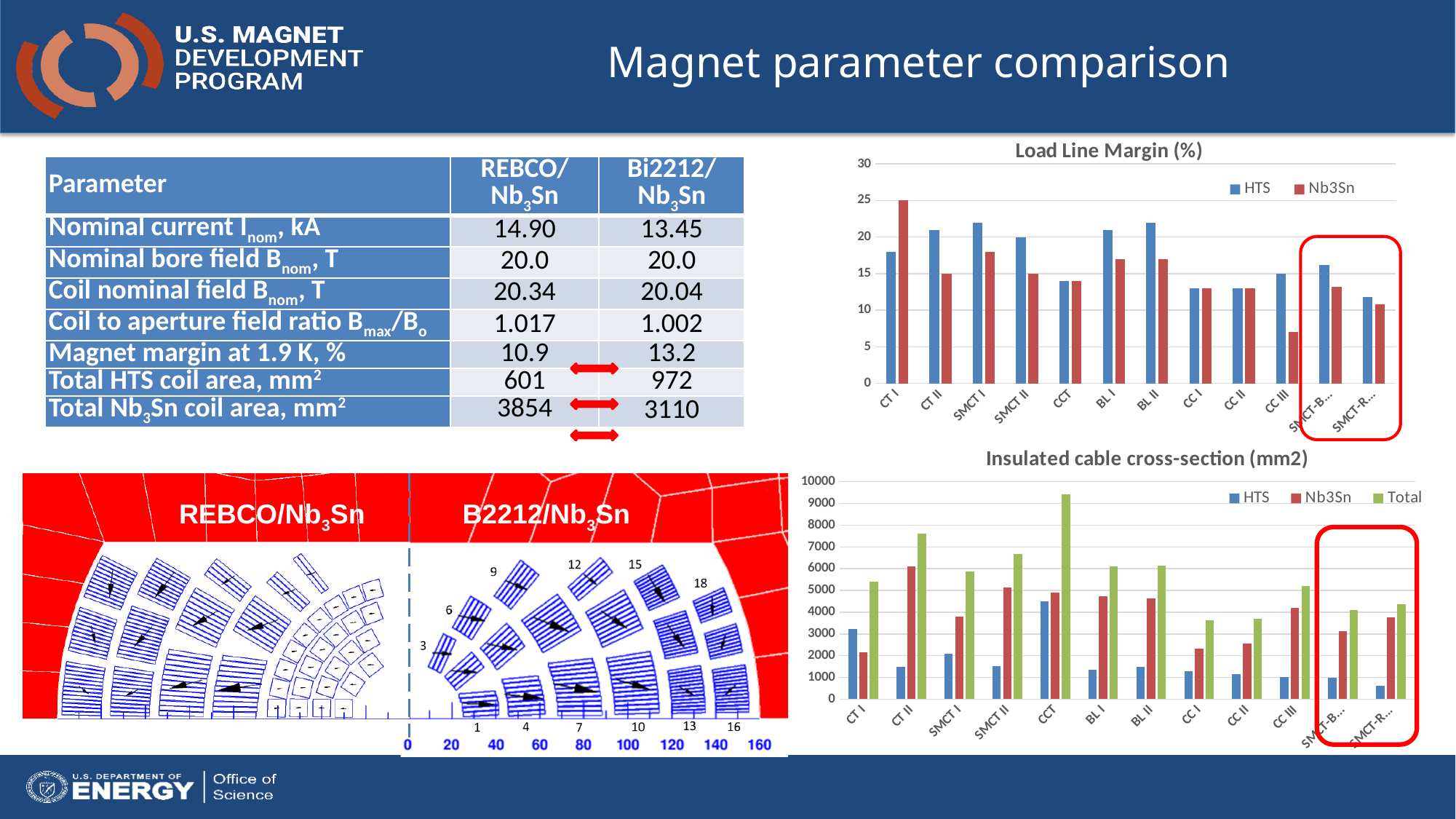
In the Load Line Margin (%) chart, is the Nb3Sn value for CC III greater or less than 10? less How many series does the legend of the Load Line Margin (%) chart list? 2 How many categories are shown on the x axis of the Load Line Margin (%) chart? 12 In the Load Line Margin (%) chart, which category has the highest Nb3Sn value? CT I In the Insulated cable cross-section (mm2) chart, is the Total value for CCT greater or less than 9000? greater In the Load Line Margin (%) chart, which is larger for CT II, the HTS value or the Nb3Sn value? HTS In the Insulated cable cross-section (mm2) chart, which is larger for CT II, the HTS value or the Nb3Sn value? Nb3Sn In the Load Line Margin (%) chart, which category has the lowest Nb3Sn value? CC III In the Insulated cable cross-section (mm2) chart, which category has the lowest HTS value? SMCT-R... In the Insulated cable cross-section (mm2) chart, which category has the highest Total value? CCT In the Load Line Margin (%) chart, is the Nb3Sn value for CT I greater or less than 20? greater How many series does the legend of the Insulated cable cross-section (mm2) chart list? 3